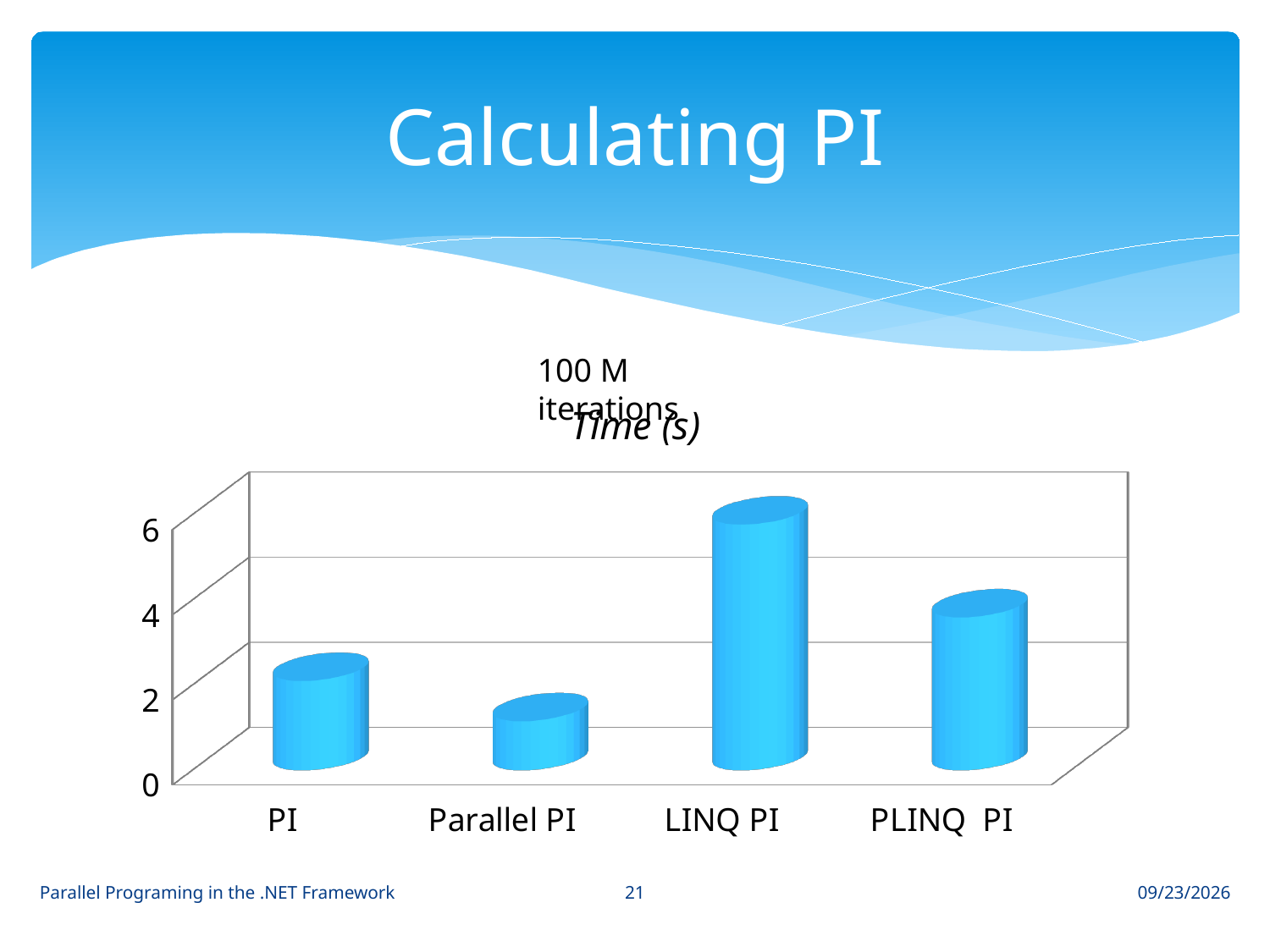
Is the value for LINQ PI greater or less than 4? greater What is the title of the chart? Time (s) Which category has the highest time? LINQ PI Which has a larger value, PI or Parallel PI? PI Is the value for Parallel PI greater or less than 2? less Is the value for PLINQ PI greater or less than 2? greater Which category has the lowest time? Parallel PI How many categories are plotted on the chart? 4 What kind of chart is shown on the slide? bar chart Which has a larger value, LINQ PI or PLINQ PI? LINQ PI How many iterations does the text above the chart say were used? 100 M